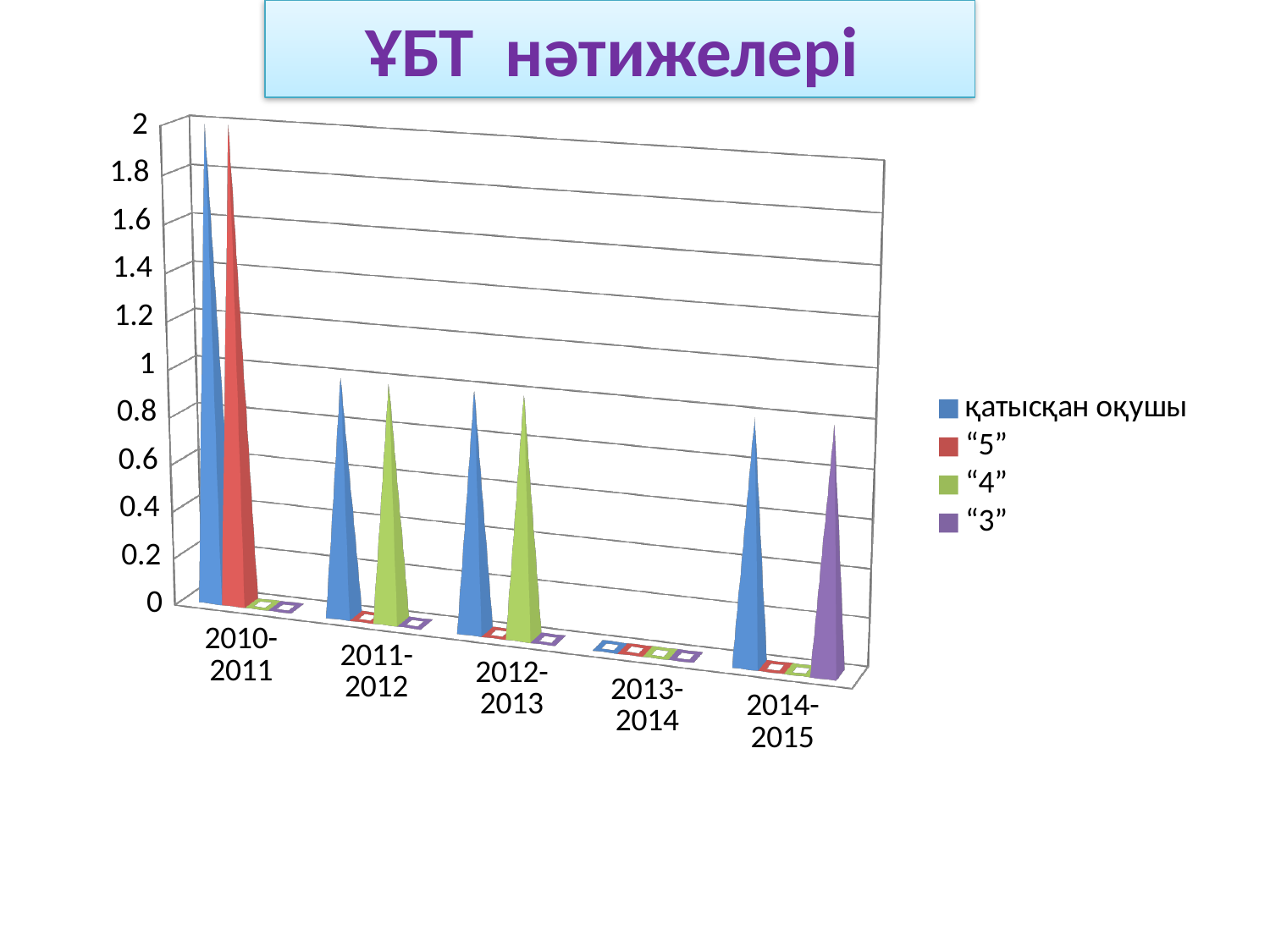
Is the value for қатысқан оқушы in 2010-2011 greater or less than 1? greater What kind of chart is shown on the slide? bar chart Which academic year has the lowest value for қатысқан оқушы? 2013-2014 In 2011-2012, which is larger: the value for "4" or the value for "5"? "4" Does the value for қатысқан оқушы rise or fall from 2010-2011 to 2011-2012? fall How many series does the legend list? 4 Which academic year has the highest value for қатысқан оқушы? 2010-2011 Is the value for "5" in 2010-2011 greater or less than 1.2? greater Which is larger: the value for "5" in 2010-2011 or the value for "5" in 2011-2012? 2010-2011 Is the value for қатысқан оқушы in 2011-2012 greater or less than 1.5? less What is the title of the chart? ҰБТ нәтижелері How many academic-year categories are shown on the x axis? 5